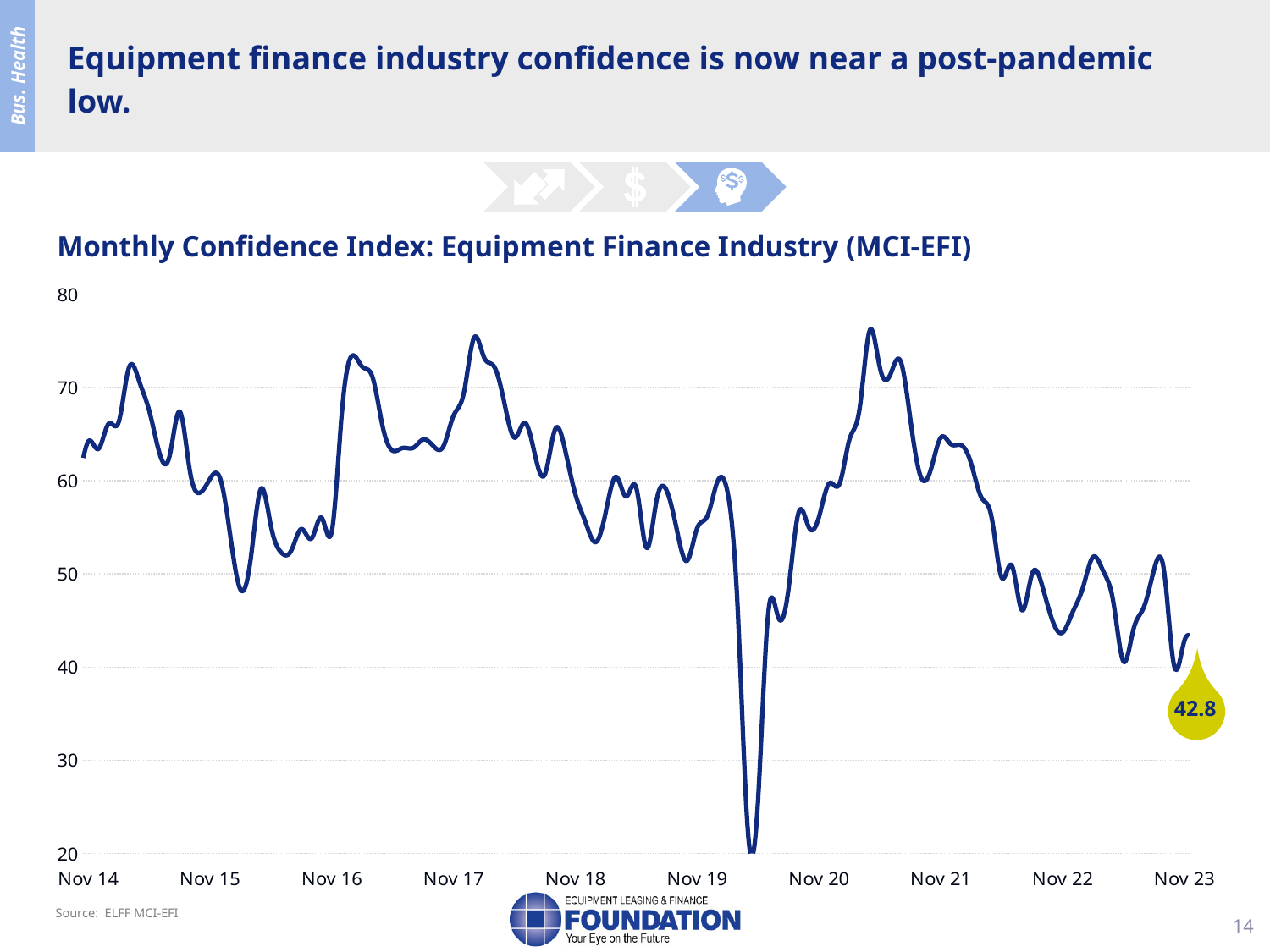
What is the title of the chart? Monthly Confidence Index: Equipment Finance Industry (MCI-EFI) Does the index rise or fall between Nov 21 and Nov 23? Fall What source is cited for the chart? ELFF MCI-EFI What kind of chart is used to show the Monthly Confidence Index? Line chart Is the value for Nov 23 greater or less than 50? less How many lines are plotted on the chart? 1 Is the value for Nov 14 greater or less than 60? greater What is the value of the MCI-EFI at Nov 23, as labeled on the chart? 42.8 Between which two x-axis labels does the lowest value on the chart occur? Between Nov 19 and Nov 20 Is the value for Nov 22 greater or less than 50? less How many labels are shown on the x axis? 10